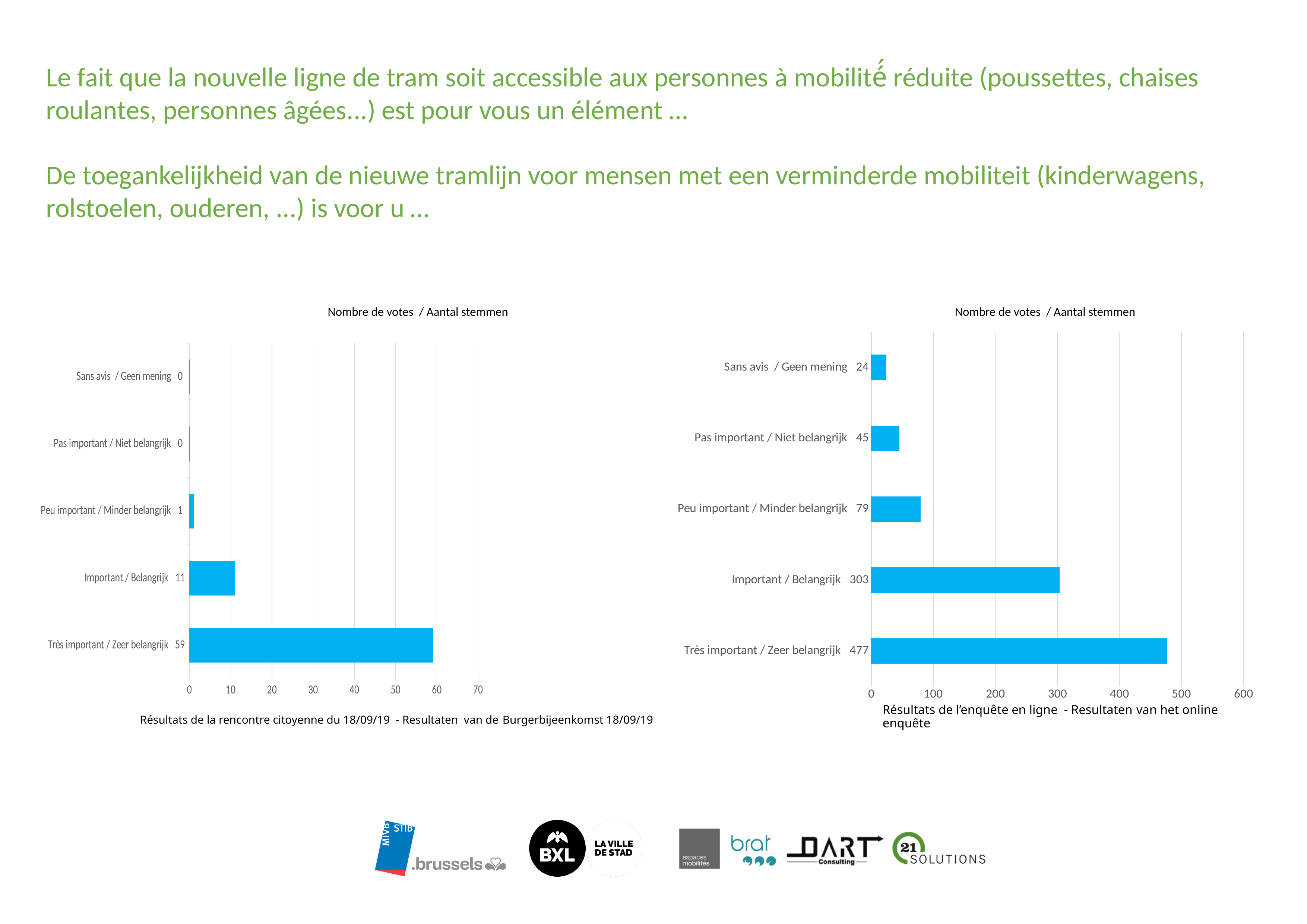
In the right chart (Résultats de l'enquête en ligne), what is the value for Peu important / Minder belangrijk? 79 In the left chart (Résultats de la rencontre citoyenne du 18/09/19), what is the difference between Très important / Zeer belangrijk and Important / Belangrijk? 48 How many categories does the left chart (Résultats de la rencontre citoyenne du 18/09/19) show? 5 What is the title shown above the left chart? Nombre de votes / Aantal stemmen In the right chart (Résultats de l'enquête en ligne), which category has the highest value? Très important / Zeer belangrijk In the right chart (Résultats de l'enquête en ligne), which is larger: Pas important / Niet belangrijk or Peu important / Minder belangrijk? Peu important / Minder belangrijk In the left chart (Résultats de la rencontre citoyenne du 18/09/19), what is the value for Important / Belangrijk? 11 In the right chart (Résultats de l'enquête en ligne), what is the value for Sans avis / Geen mening? 24 In the left chart (Résultats de la rencontre citoyenne du 18/09/19), what is the value for Très important / Zeer belangrijk? 59 In the right chart (Résultats de l'enquête en ligne), which category has the lowest value? Sans avis / Geen mening What kind of chart is the right chart (Résultats de l'enquête en ligne)? Bar chart In the right chart (Résultats de l'enquête en ligne), what is the difference between Très important / Zeer belangrijk and Important / Belangrijk? 174